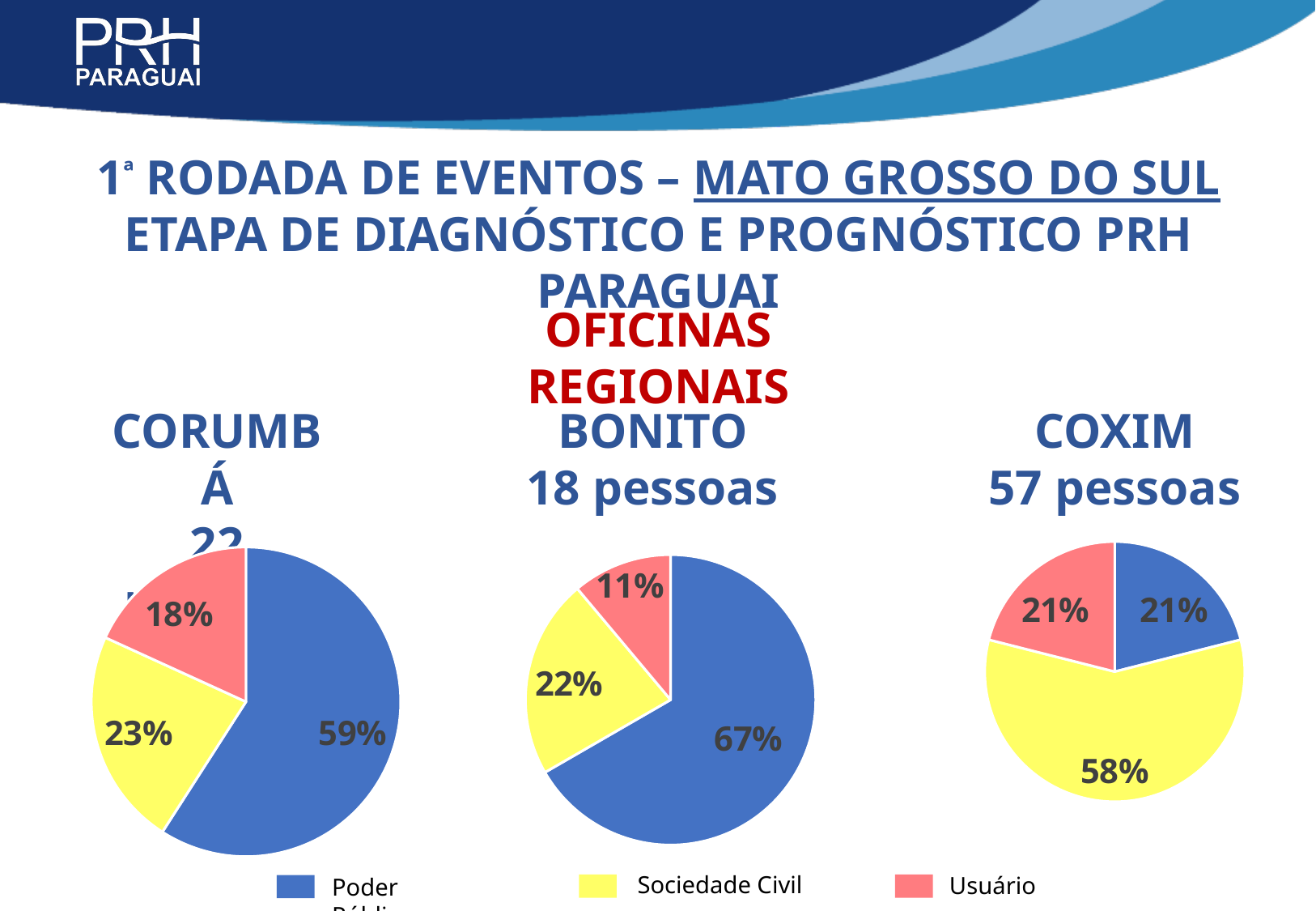
Which is larger: the Sociedade Civil share in the COXIM chart or the Sociedade Civil share in the BONITO chart? COXIM In the BONITO pie chart, what share does Usuário have? 11% In the CORUMBÁ pie chart, what share does Sociedade Civil (yellow) have? 23% How many slices does the COXIM pie chart have? 3 In the BONITO pie chart, which category has the smallest share? Usuário In the CORUMBÁ pie chart, what share is labelled for the blue slice? 59% In the BONITO pie chart, what is the difference between the Sociedade Civil share and the Usuário share? 11% What type of chart is used for BONITO? Pie chart In the BONITO pie chart, what share does the blue slice have? 67% In the COXIM pie chart, which category has the largest share? Sociedade Civil In the COXIM pie chart, what share does Sociedade Civil have? 58%